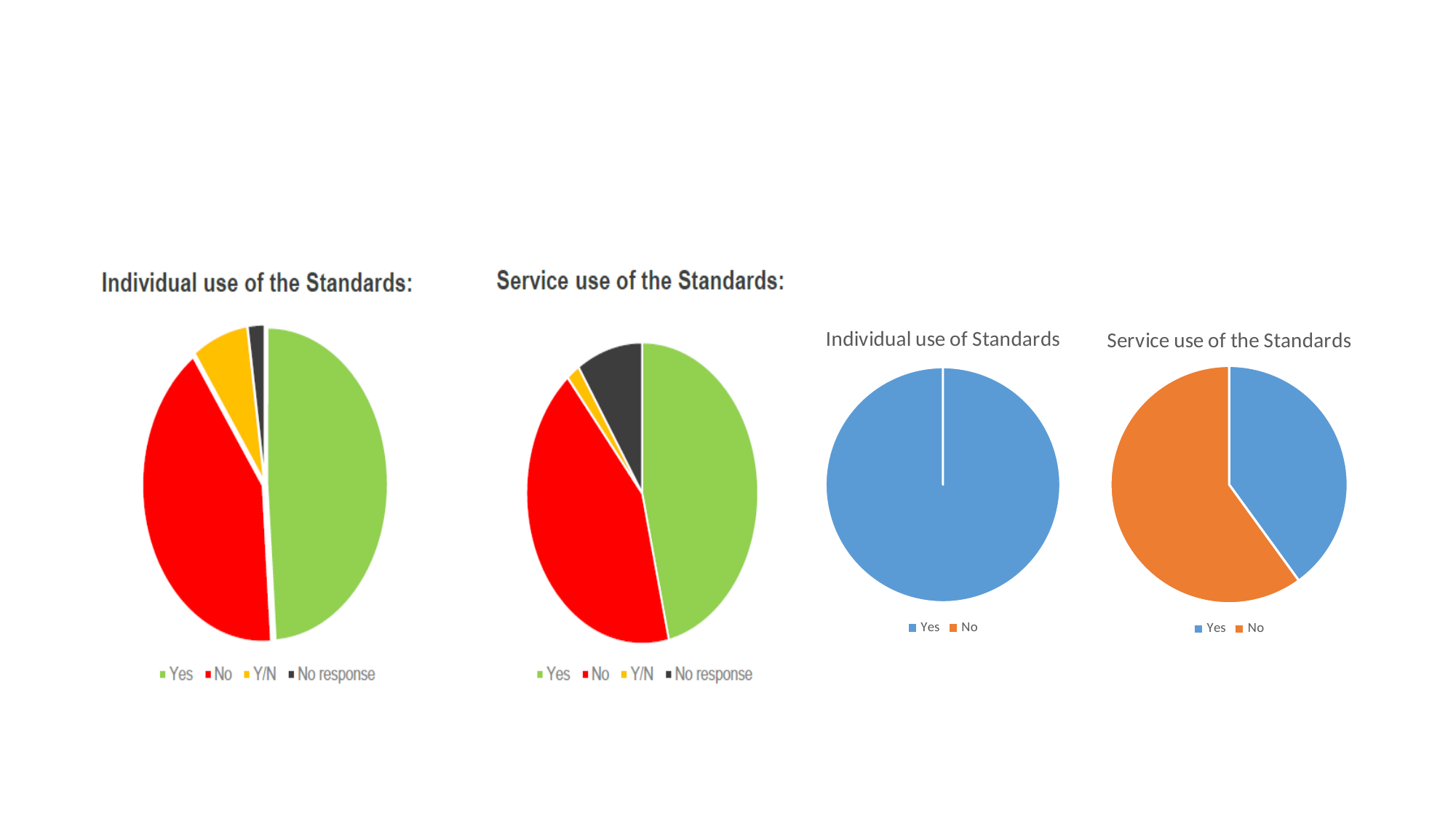
In the second pie chart from the left, "Service use of the Standards:", which slice is larger, No response or Y/N? No response In the leftmost pie chart "Individual use of the Standards:", which category has the largest slice? Yes In the leftmost pie chart "Individual use of the Standards:", which slice is larger, Y/N or No? No In the second pie chart from the left, "Service use of the Standards:", which category has the smallest slice? Y/N In the second pie chart from the left, "Service use of the Standards:", which category has the largest slice? Yes In the rightmost pie chart "Service use of the Standards" (blue and orange), which category has the larger slice? No How many entries does the legend of the second pie chart from the left, "Service use of the Standards:", list? 4 What kind of chart is the leftmost chart titled "Individual use of the Standards:"? pie chart In the leftmost pie chart "Individual use of the Standards:", which category has the smallest slice? No response What colour represents "Yes" in the rightmost pie chart "Service use of the Standards"? blue How many slices does the leftmost pie chart "Individual use of the Standards:" have? 4